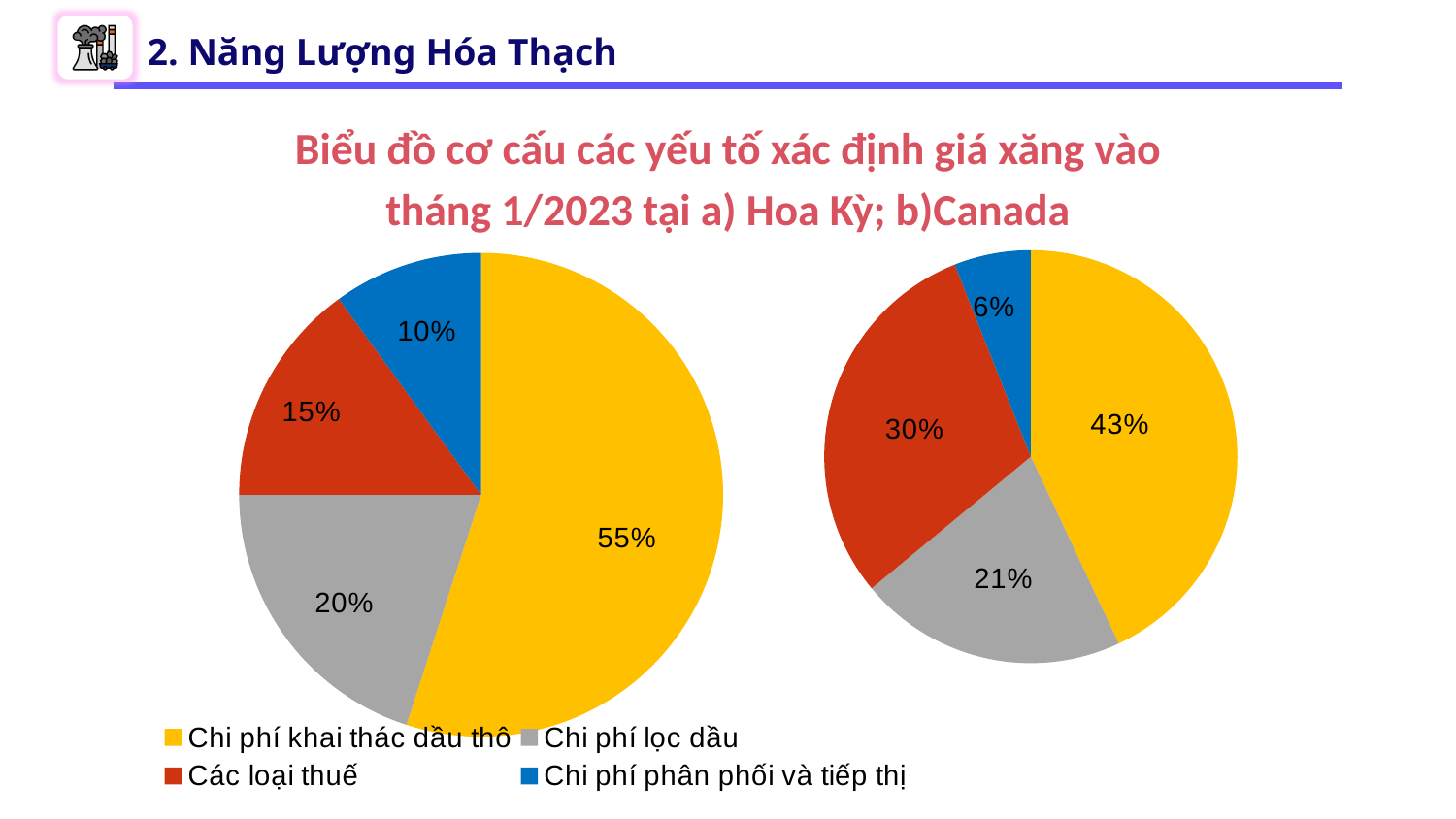
In the right pie chart (b) Canada), what share is labelled for Các loại thuế? 30% Which colour represents Chi phí lọc dầu in the legend? Gray Which is larger in the right pie chart (b) Canada): the share for Các loại thuế or the share for Chi phí lọc dầu? Các loại thuế What type of chart is used on this slide? Pie chart What is the difference between the Chi phí khai thác dầu thô share in the left pie chart (a) Hoa Kỳ) and in the right pie chart (b) Canada)? 12% In the left pie chart (a) Hoa Kỳ), what share is labelled for Chi phí khai thác dầu thô? 55% In the left pie chart (a) Hoa Kỳ), which category has the largest slice? Chi phí khai thác dầu thô How many entries does the legend list? 4 In the right pie chart (b) Canada), which category has the smallest slice? Chi phí phân phối và tiếp thị In the right pie chart (b) Canada), what share is labelled for Chi phí phân phối và tiếp thị? 6% How many slices does the left pie chart (a) Hoa Kỳ) have? 4 In the left pie chart (a) Hoa Kỳ), what is the difference between the shares for Chi phí lọc dầu and Các loại thuế? 5%